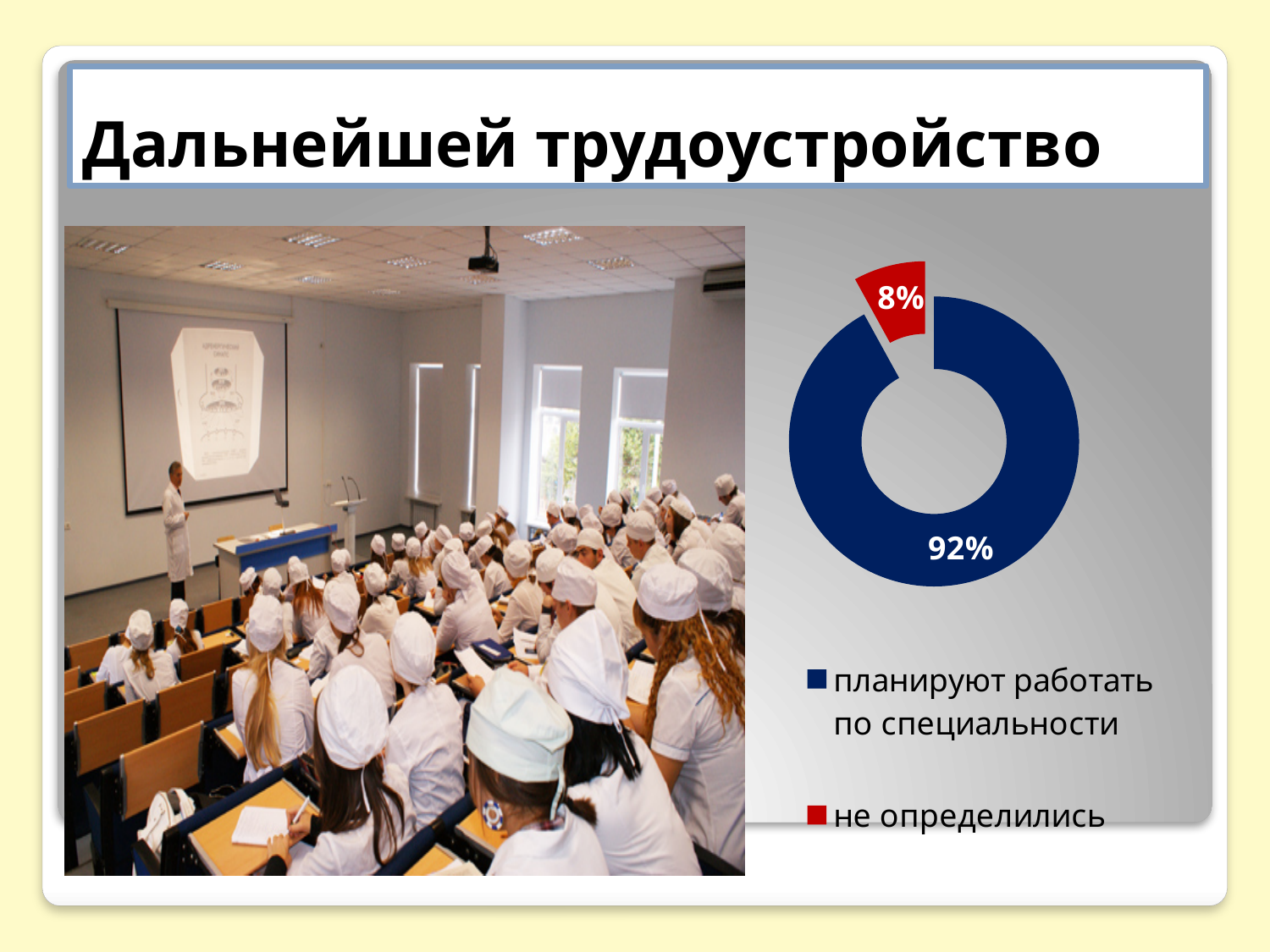
How many entries does the legend list? 2 What is the difference in percentage points between the two slices of the chart? 84 Which category has the smallest share in the chart? не определились Which category has the largest share in the chart? планируют работать по специальности What colour is the slice for "планируют работать по специальности"? dark blue What kind of chart is shown on the slide? doughnut (pie) chart How many categories does the chart show? 2 What share of the chart is labelled "не определились"? 8% What share of the chart is labelled "планируют работать по специальности"? 92% Which is larger: the share for "планируют работать по специальности" or for "не определились"? планируют работать по специальности What colour is the slice for "не определились"? red What is the total of the two slice percentages shown in the chart? 100%